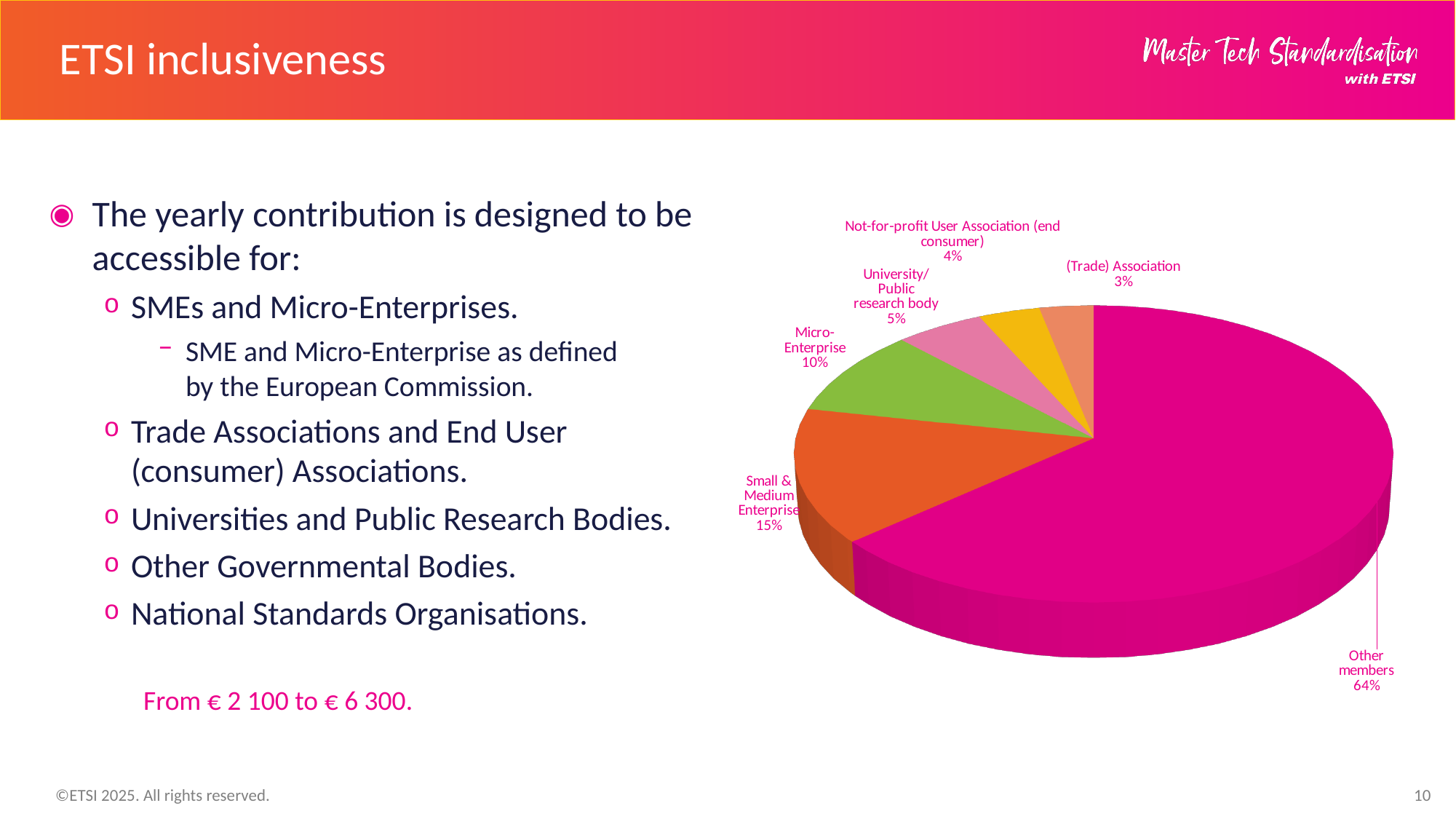
What share of the pie is Other members? 64% What kind of chart is shown on the slide? pie chart Which category has the largest slice of the pie? Other members How many slices does the pie chart have? 6 What share of the pie is Micro-Enterprise? 10% Which is larger, the share for Micro-Enterprise or the share for University/Public research body? Micro-Enterprise What share of the pie is Not-for-profit User Association (end consumer)? 4% What is the difference in percentage points between Small & Medium Enterprise and Micro-Enterprise? 5 Which category has the smallest slice of the pie? (Trade) Association